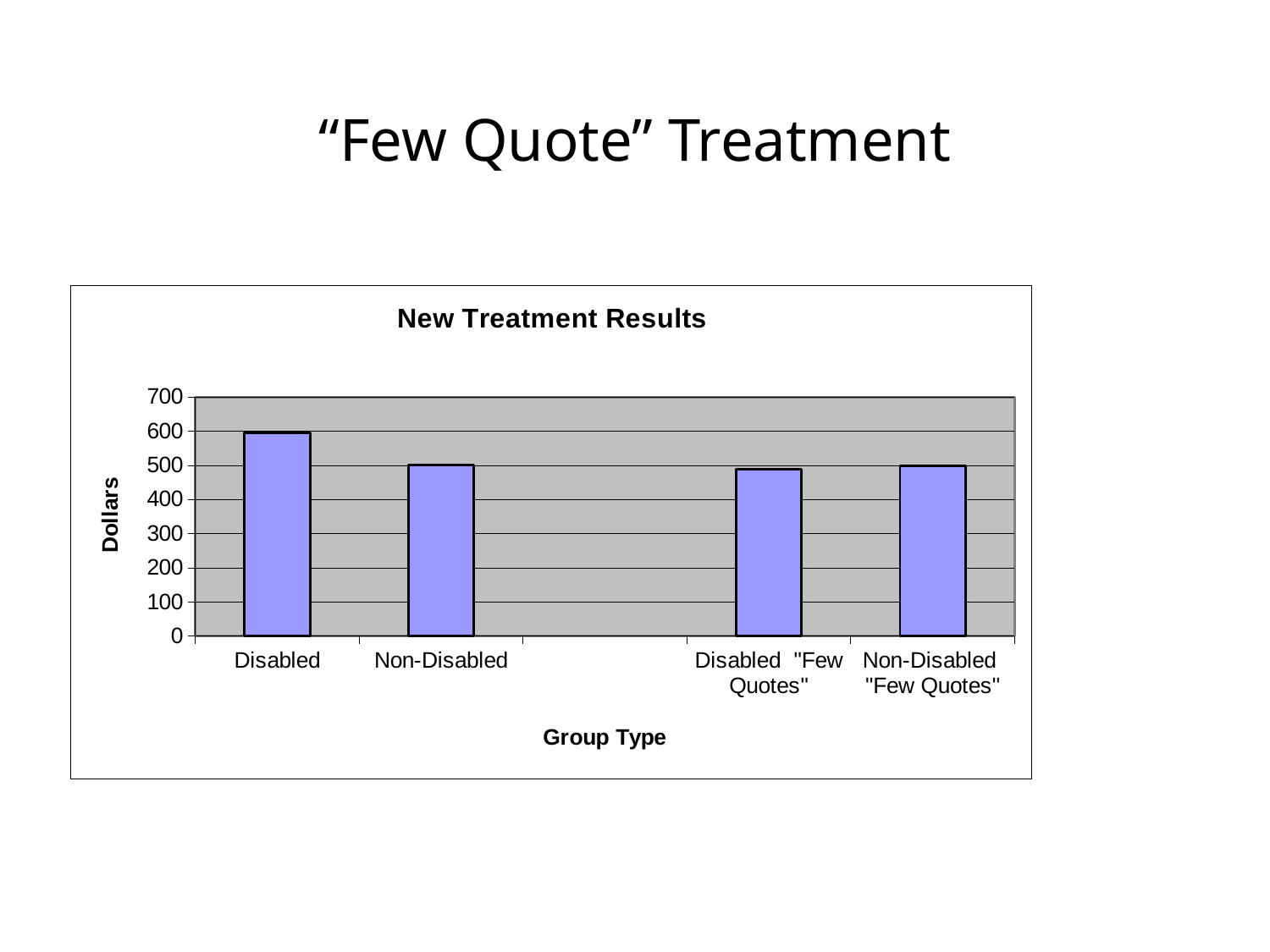
Which is larger, the value for Disabled or the value for Disabled "Few Quotes"? Disabled What is the label on the vertical axis of the chart? Dollars How many group types are plotted in the chart? 4 Is the value for Non-Disabled greater or less than 300? greater Which group type has the highest value in the chart? Disabled Is the value for Disabled greater or less than 500? greater Is the value for Non-Disabled "Few Quotes" greater or less than 400? greater What is the title of the chart? New Treatment Results Which is larger, the value for Disabled or the value for Non-Disabled? Disabled What kind of chart is shown on the slide? bar chart